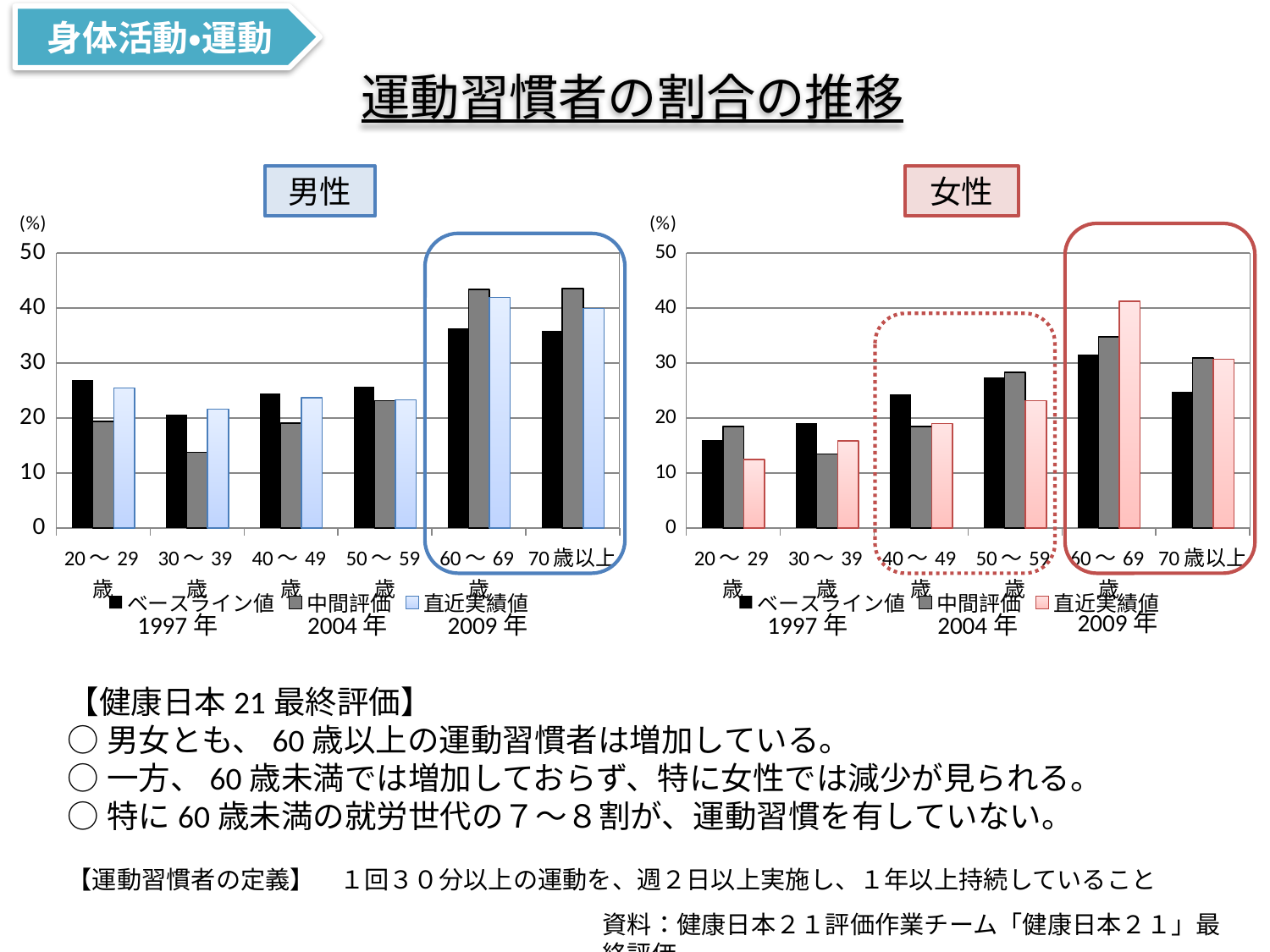
In the 男性 chart, for 20～29歳, which is larger: the ベースライン値 or the 中間評価? ベースライン値 In the 女性 chart, is the 直近実績値 value for 60～69歳 greater or less than 40? greater In the 女性 chart, for 60～69歳, which is larger: the ベースライン値 or the 直近実績値? 直近実績値 What is the title of the slide's charts? 運動習慣者の割合の推移 In the 男性 chart, which age category has the lowest 中間評価 value? 30～39歳 How many series does the legend of the 男性 chart list? 3 What kind of chart is the 男性 chart? bar chart In the 女性 chart, is the 直近実績値 value for 20～29歳 greater or less than 20? less In the 男性 chart, is the 中間評価 value for 30～39歳 greater or less than 20? less How many age categories are shown on the x axis of the 女性 chart? 6 In the 女性 chart, which age category has the highest 直近実績値 value? 60～69歳